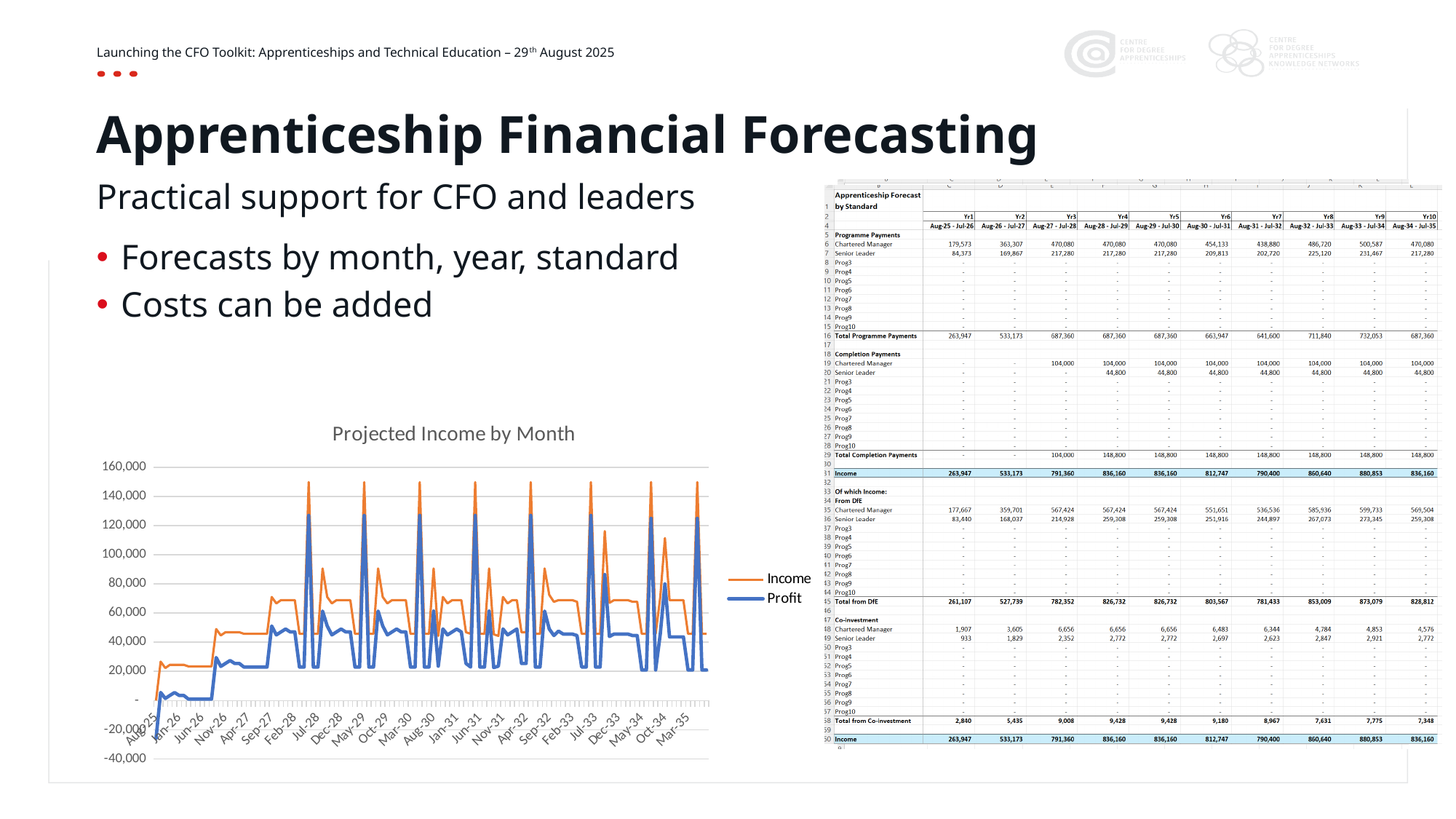
In the 'Projected Income by Month' chart, which series reaches the higher peak values, Income or Profit? Income What are the two series named in the legend of the 'Projected Income by Month' chart? Income and Profit In the 'Projected Income by Month' chart, is the Income value at Sep-27 greater or less than 60,000? greater In the 'Projected Income by Month' chart, is the highest Profit peak greater or less than 100,000? greater In the 'Projected Income by Month' chart, is the Profit value at Jan-26 greater or less than 20,000? less In the 'Projected Income by Month' chart, which series is drawn in orange? Income How many series does the legend of the 'Projected Income by Month' chart list? 2 In the 'Projected Income by Month' chart, does the Income line rise or fall between Aug-25 and Nov-26? rise How many month labels are shown on the x axis of the 'Projected Income by Month' chart? 24 What type of chart is 'Projected Income by Month'? line chart